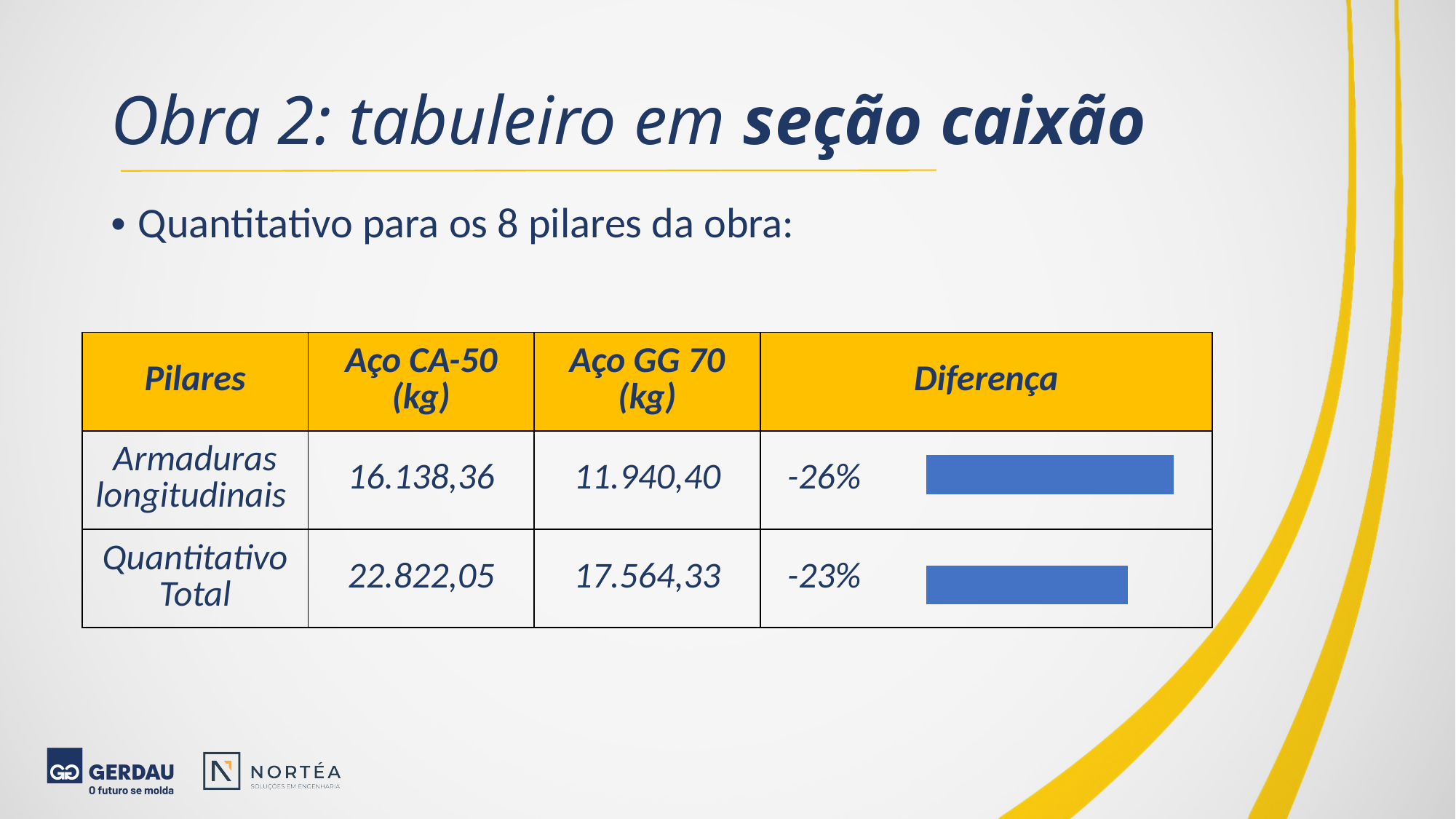
For Quantitativo Total, which is larger: the Aço CA-50 value or the Aço GG 70 value? Aço CA-50 What is the Aço GG 70 (kg) value for Armaduras longitudinais? 11.940,40 Which row has the longer bar in the Diferença column? Armaduras longitudinais What is the Diferença value shown for Quantitativo Total? -23% Which row has the smaller percentage reduction in the Diferença column? Quantitativo Total How many bars are drawn in the Diferença column? 2 What colour are the bars in the Diferença column? Blue What is the Aço CA-50 (kg) value for Armaduras longitudinais? 16.138,36 What is the Diferença value shown for Armaduras longitudinais? -26% What is the Aço GG 70 (kg) value for Quantitativo Total? 17.564,33 By how many percentage points does the Diferença for Armaduras longitudinais exceed that of Quantitativo Total in magnitude? 3 percentage points What kind of chart is drawn in the Diferença column? Bar chart